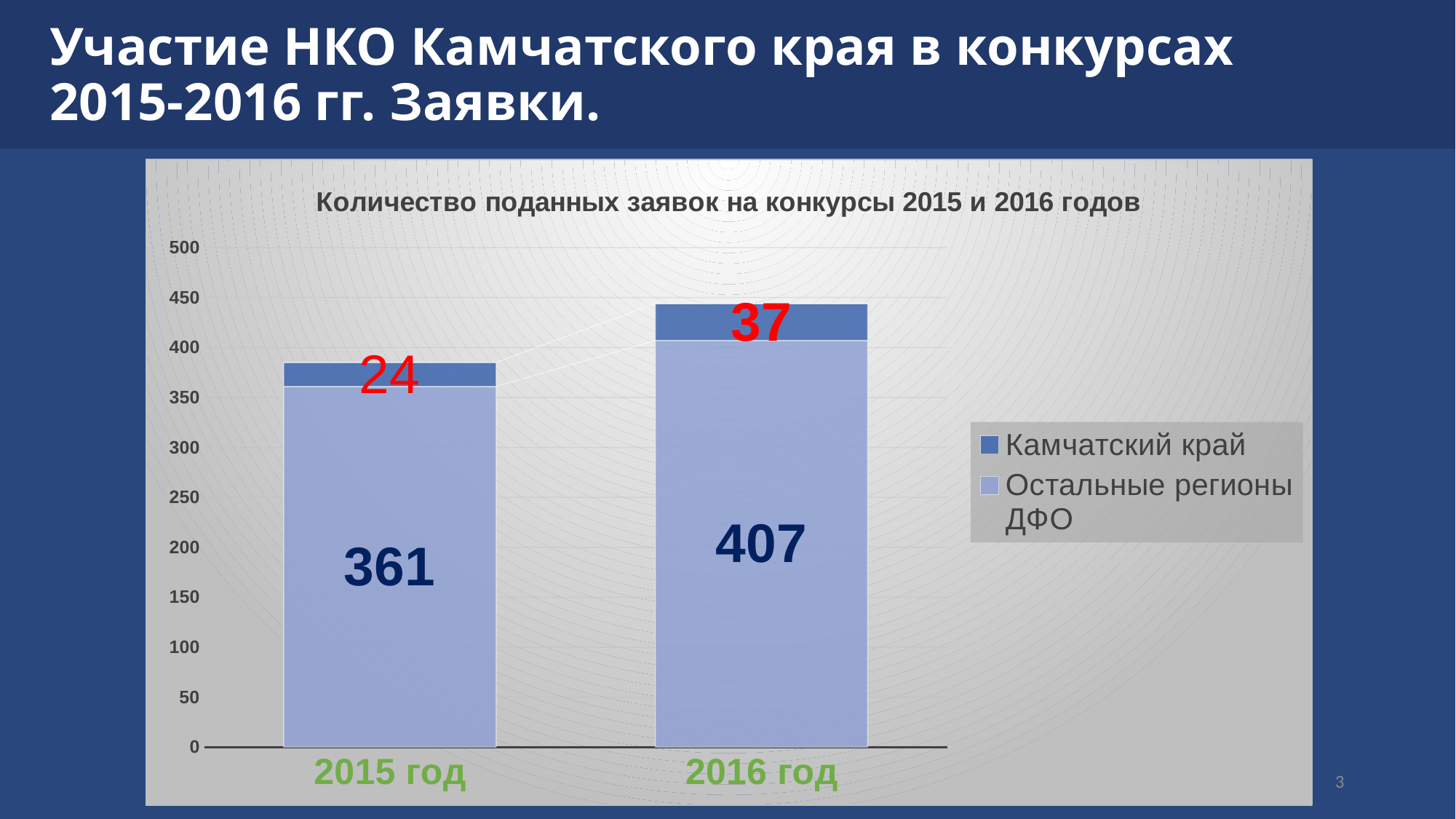
How many series does the legend list? 2 What kind of chart is shown on the slide? Stacked bar chart What is the value for Камчатский край in 2015 год? 24 What is the value for Остальные регионы ДФО in 2016 год? 407 What is the value for Остальные регионы ДФО in 2015 год? 361 What is the value for Камчатский край in 2016 год? 37 What is the title of the chart? Количество поданных заявок на конкурсы 2015 и 2016 годов What is the total of the stacked bar for 2016 год? 444 How many categories are shown on the x axis? 2 Which year has the higher value for Камчатский край? 2016 год What is the total of the stacked bar for 2015 год? 385 What is the difference between the Остальные регионы ДФО values for 2016 год and 2015 год? 46